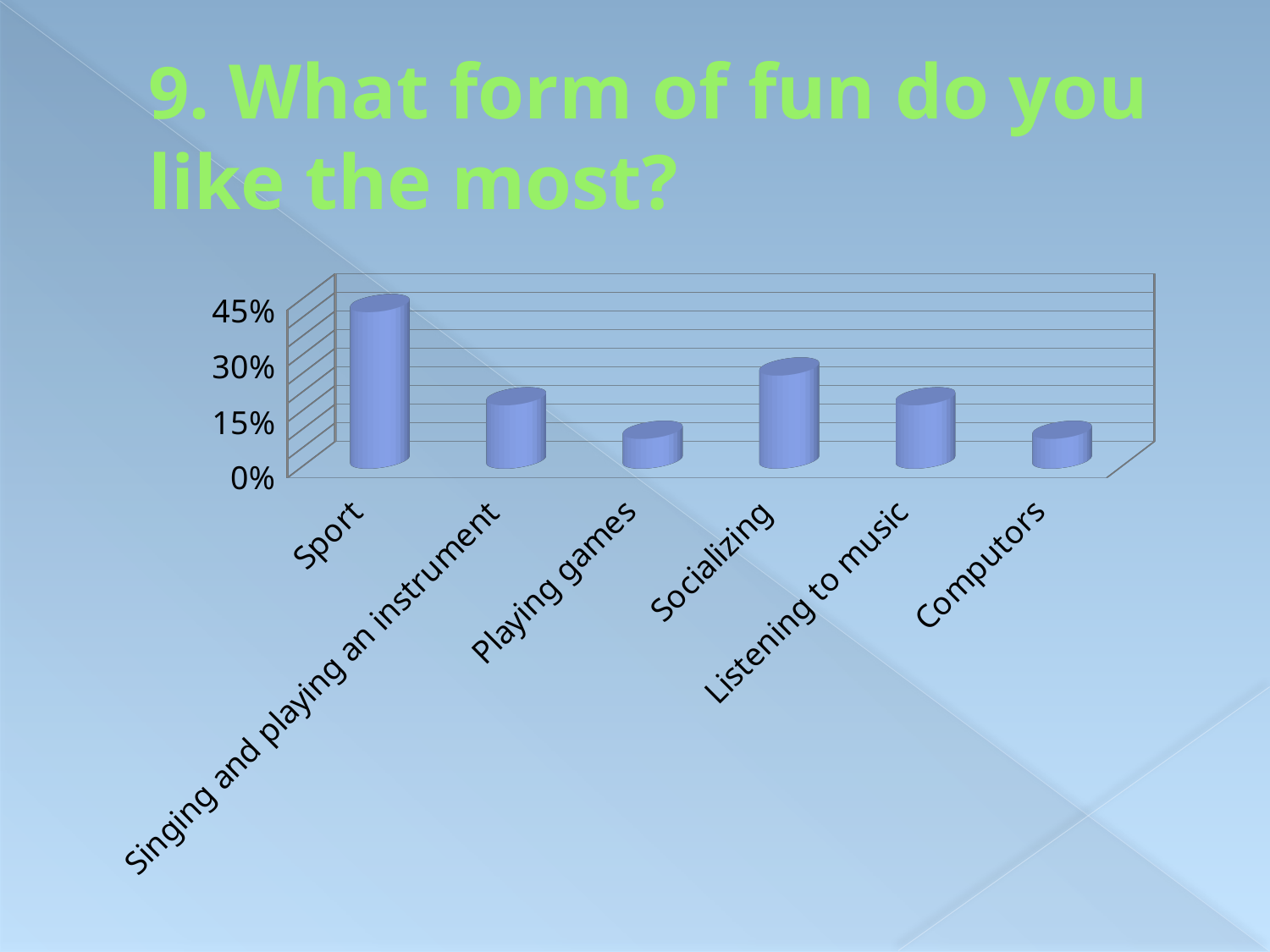
Which is larger, the value for Sport or the value for Socializing? Sport Is the value for Singing and playing an instrument greater or less than 30%? less Which is larger, the value for Socializing or the value for Listening to music? Socializing Is the value for Socializing greater or less than 45%? less How many categories are shown on the x axis of the chart? 6 Which category has the highest value in the chart? Sport What kind of chart is shown on the slide? bar chart Is the value for Sport greater or less than 30%? greater What is the title of the slide containing the chart? 9. What form of fun do you like the most?